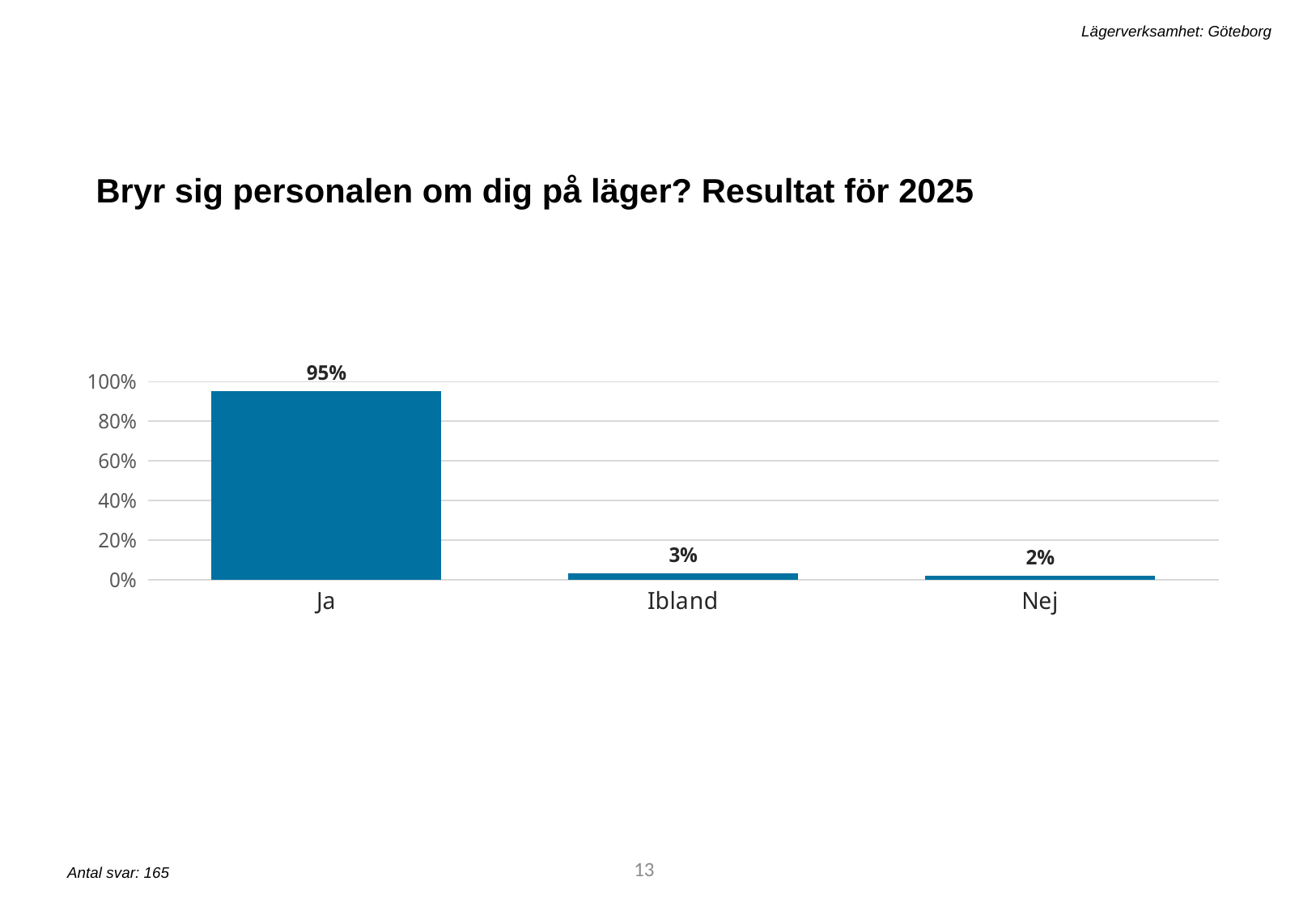
What is the difference between the values for Ibland and Nej? 1% What is the difference between the values for Ja and Ibland? 92% How many categories are shown on the x axis? 3 What is the value for Nej? 2% What is the value for Ibland? 3% Is the value for Ja greater or less than 80%? greater What kind of chart is shown on the slide? bar chart What is the title of the chart on the slide? Bryr sig personalen om dig på läger? Resultat för 2025 Which is larger, the value for Ja or the value for Nej? Ja Which category has the lowest value? Nej Which category has the highest value? Ja What is the value for Ja? 95%